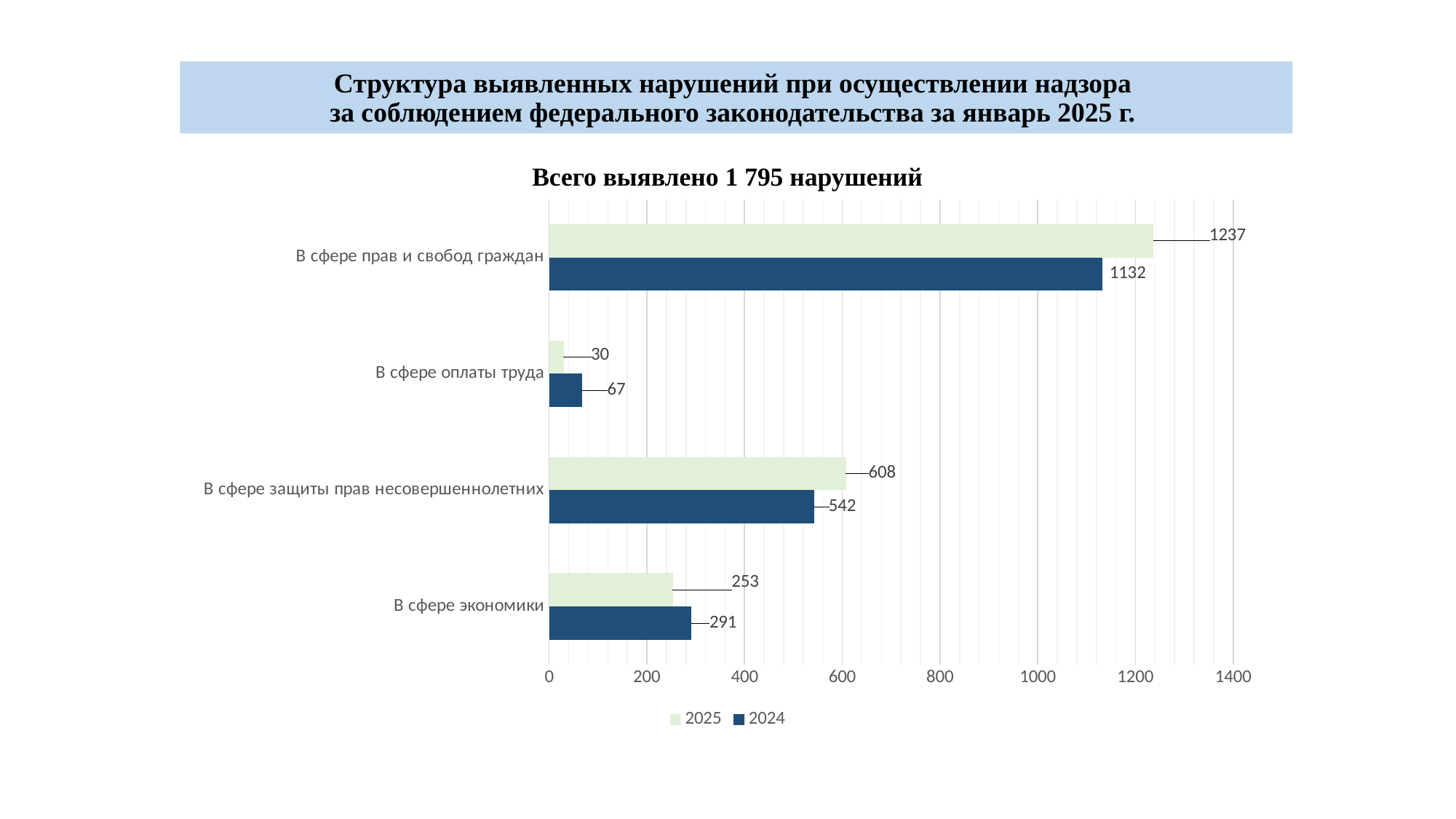
How many categories are shown on the chart? 4 Which is larger for «В сфере экономики»: the 2025 value or the 2024 value? 2024 What is the 2025 value for «В сфере защиты прав несовершеннолетних»? 608 What is the 2024 value for «В сфере экономики»? 291 Which category has the highest 2025 value? В сфере прав и свобод граждан How many series does the legend list? 2 Is the 2024 value for «В сфере защиты прав несовершеннолетних» greater or less than 600? less What is the 2025 value for «В сфере прав и свобод граждан»? 1237 Which category has the lowest 2024 value? В сфере оплаты труда What is the difference between the 2025 and 2024 values for «В сфере прав и свобод граждан»? 105 What is the 2024 value for «В сфере оплаты труда»? 67 What kind of chart is shown on the slide? bar chart